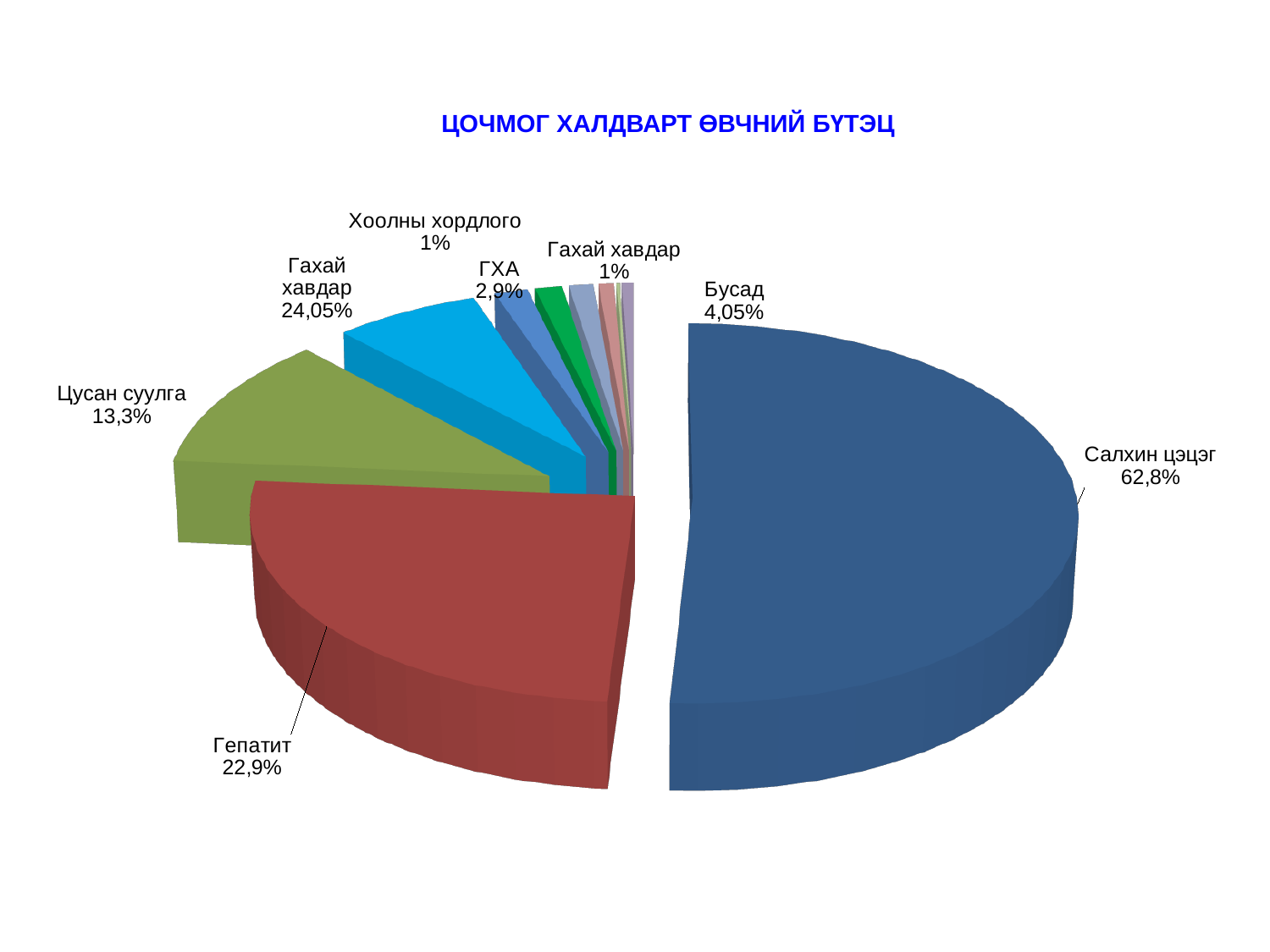
By how many percentage points does the share for Салхин цэцэг exceed the share for Гепатит? 39,9% Which category has the largest slice of the pie? Салхин цэцэг What kind of chart is shown on the slide? pie chart What percentage is shown for ГХА? 2,9% Which is larger, the share for Бусад or the share for ГХА? Бусад What percentage is shown for Хоолны хордлого? 1% Which is larger, the share for Гепатит or the share for Цусан суулга? Гепатит What share of the pie is labelled for Салхин цэцэг? 62,8% What is the title of the chart? ЦОЧМОГ ХАЛДВАРТ ӨВЧНИЙ БҮТЭЦ What percentage is shown for Гепатит? 22,9% What percentage is shown for Цусан суулга? 13,3% What percentage is shown for Бусад? 4,05%